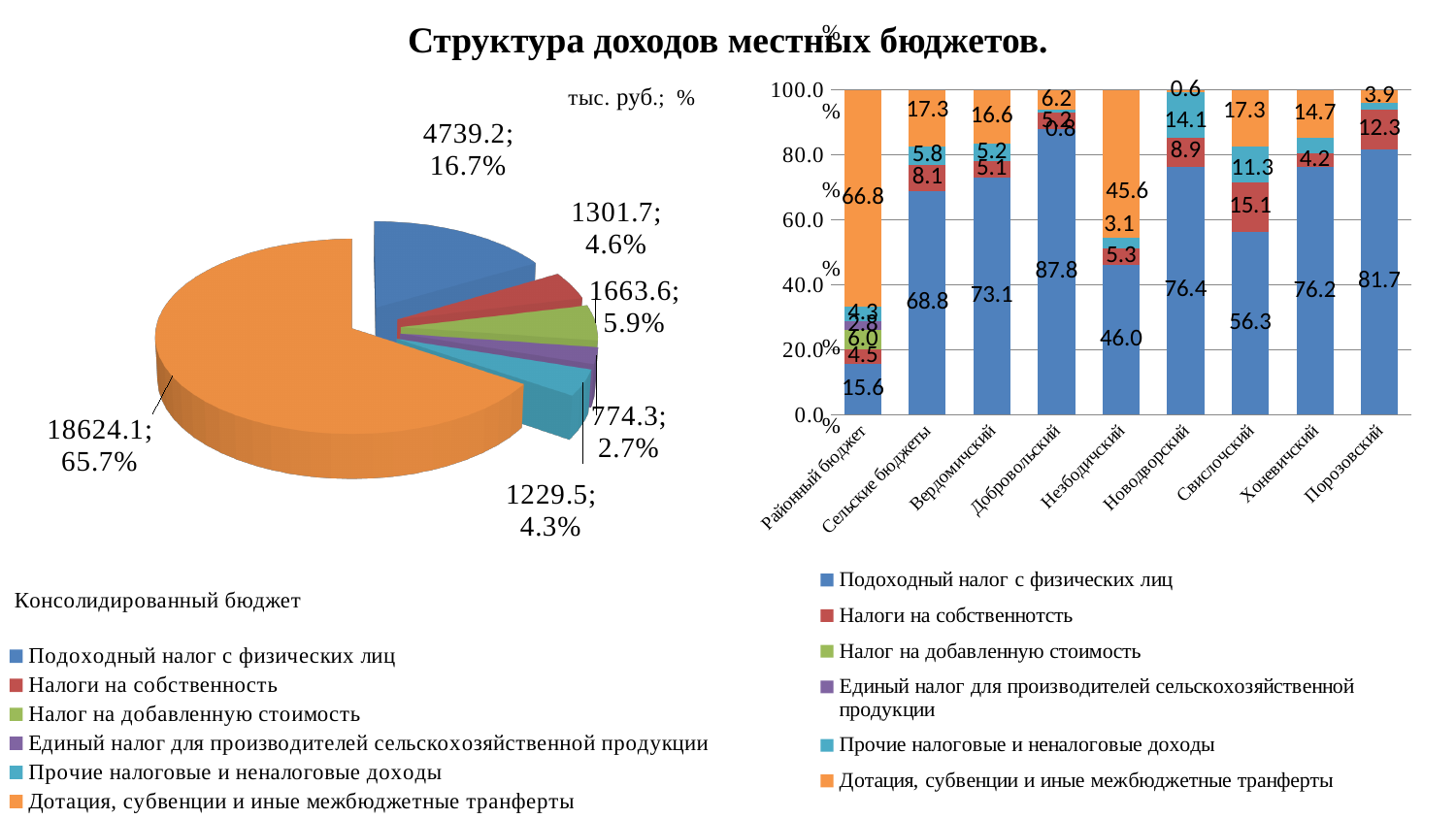
In the pie chart on the left, what value is shown for the largest slice (Дотация, субвенции и иные межбюджетные трансферты)? 18624.1; 65.7% In the bar chart on the right, what is the value of Подоходный налог с физических лиц for Добровольский? 87.8 In the pie chart on the left, what share of the pie does the blue slice (Подоходный налог с физических лиц) represent? 16.7% In the bar chart on the right, what is the value of Дотация, субвенции и иные межбюджетные трансферты for Районный бюджет? 66.8 What type of chart is on the right side of the slide? Stacked bar chart How many slices does the pie chart on the left have? 6 In the bar chart on the right, is the Подоходный налог с физических лиц value larger for Порозовский or for Свислочский? Порозовский In the bar chart on the right, how many categories are shown on the x axis? 9 In the pie chart on the left, which slice is the smallest? Единый налог для производителей сельскохозяйственной продукции (774.3; 2.7%) How many series does the legend of the bar chart on the right list? 6 In the pie chart on the left, what is the difference between the values 1663.6 and 1301.7? 361.9 In the bar chart on the right, which category has the lowest value for Подоходный налог с физических лиц? Районный бюджет